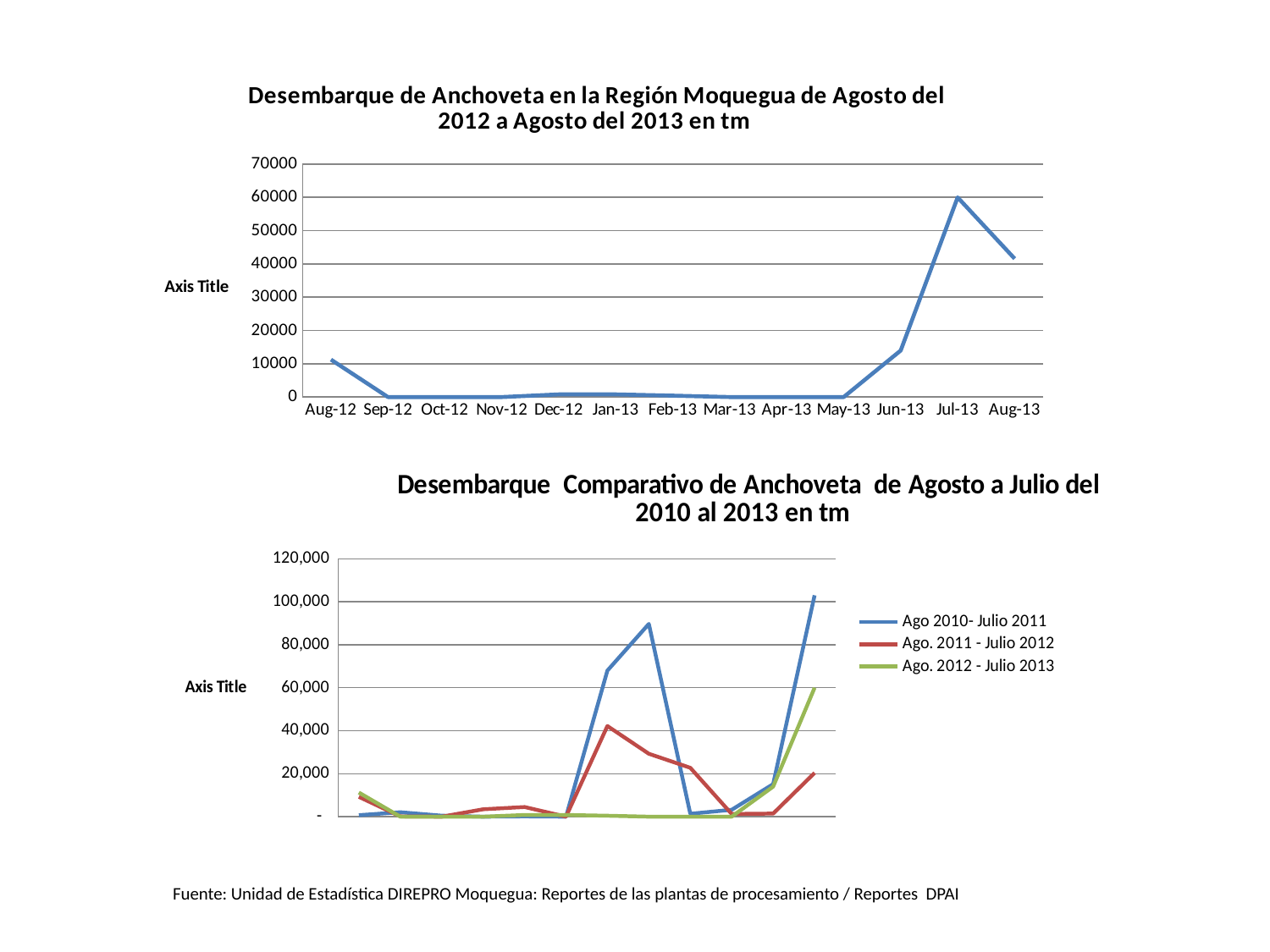
In the top chart, is the value for Aug-13 greater or less than 50000? less In the top chart, which month has the highest value? Jul-13 In the top chart, how many months are plotted along the x axis? 13 In the top chart, which is larger, the value for Aug-12 or the value for Jul-13? Jul-13 What kind of chart is the top chart, 'Desembarque de Anchoveta en la Región Moquegua de Agosto del 2012 a Agosto del 2013 en tm'? Line chart In the top chart, is the value for Jun-13 greater or less than 10000? greater In the bottom chart, what are the three legend entries? Ago 2010- Julio 2011, Ago. 2011 - Julio 2012, Ago. 2012 - Julio 2013 In the top chart, do the values rise or fall from May-13 to Jul-13? Rise How many series does the legend of the bottom chart, 'Desembarque Comparativo de Anchoveta de Agosto a Julio del 2010 al 2013 en tm', list? 3 In the top chart, is the value for Jul-13 greater or less than 50000? greater In the bottom chart, which series reaches the highest peak value? Ago 2010- Julio 2011